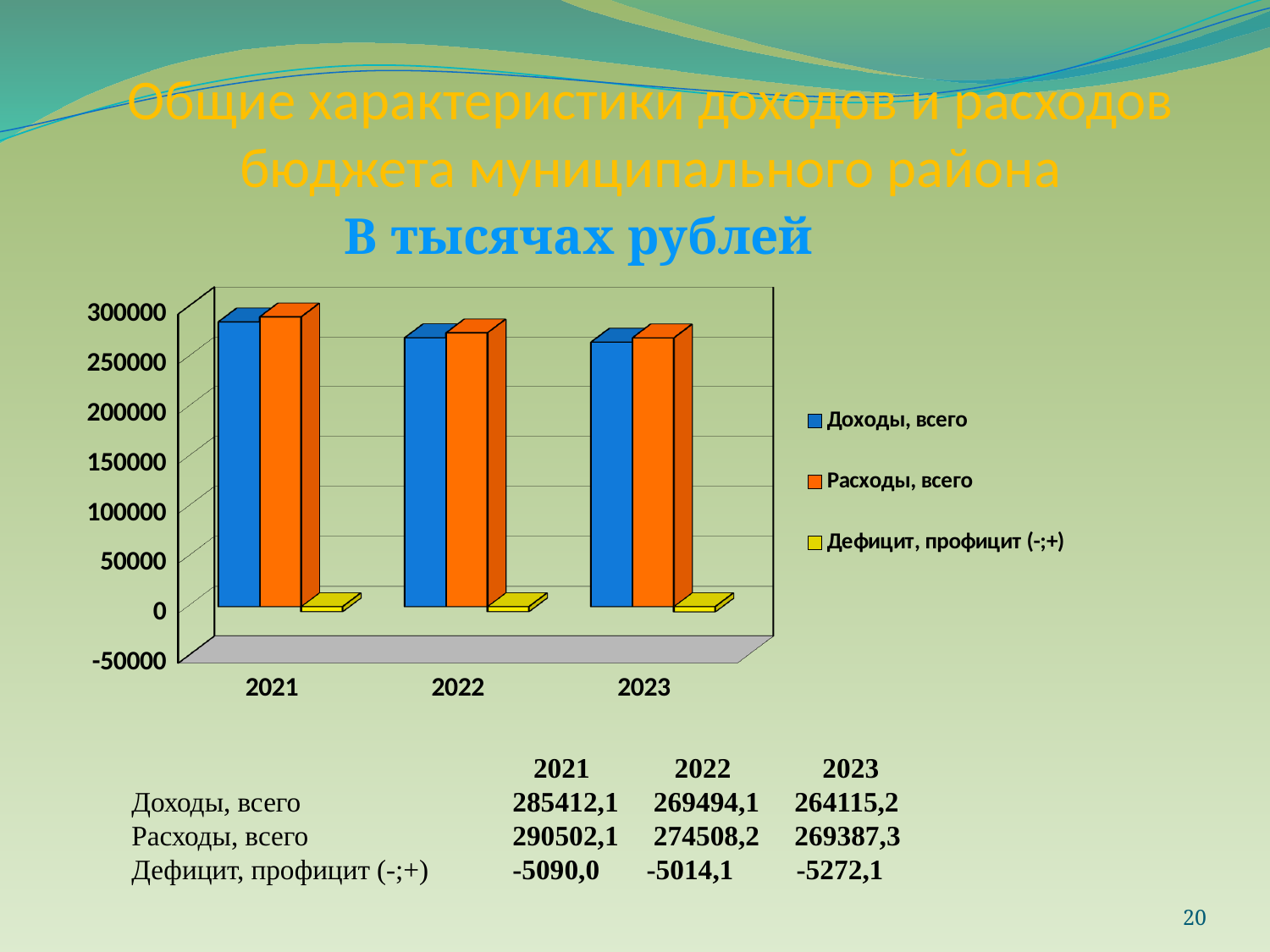
In which year is Доходы, всего the highest? 2021 How many series does the legend list? 3 What is the value of Расходы, всего for 2023? 269387,3 By how much did Доходы, всего decrease from 2021 to 2023? 21296,9 Is the value of Доходы, всего for 2023 greater or less than 250000? greater What is the difference between Расходы, всего and Доходы, всего in 2021? 5090,0 In which year is Расходы, всего the lowest? 2023 In 2022, which is larger: Доходы, всего or Расходы, всего? Расходы, всего What is the value of Дефицит, профицит (-;+) for 2022? -5014,1 Does Доходы, всего rise or fall from 2021 to 2023? fall What is the value of Доходы, всего for 2021? 285412,1 How many years are shown on the x axis of the chart? 3